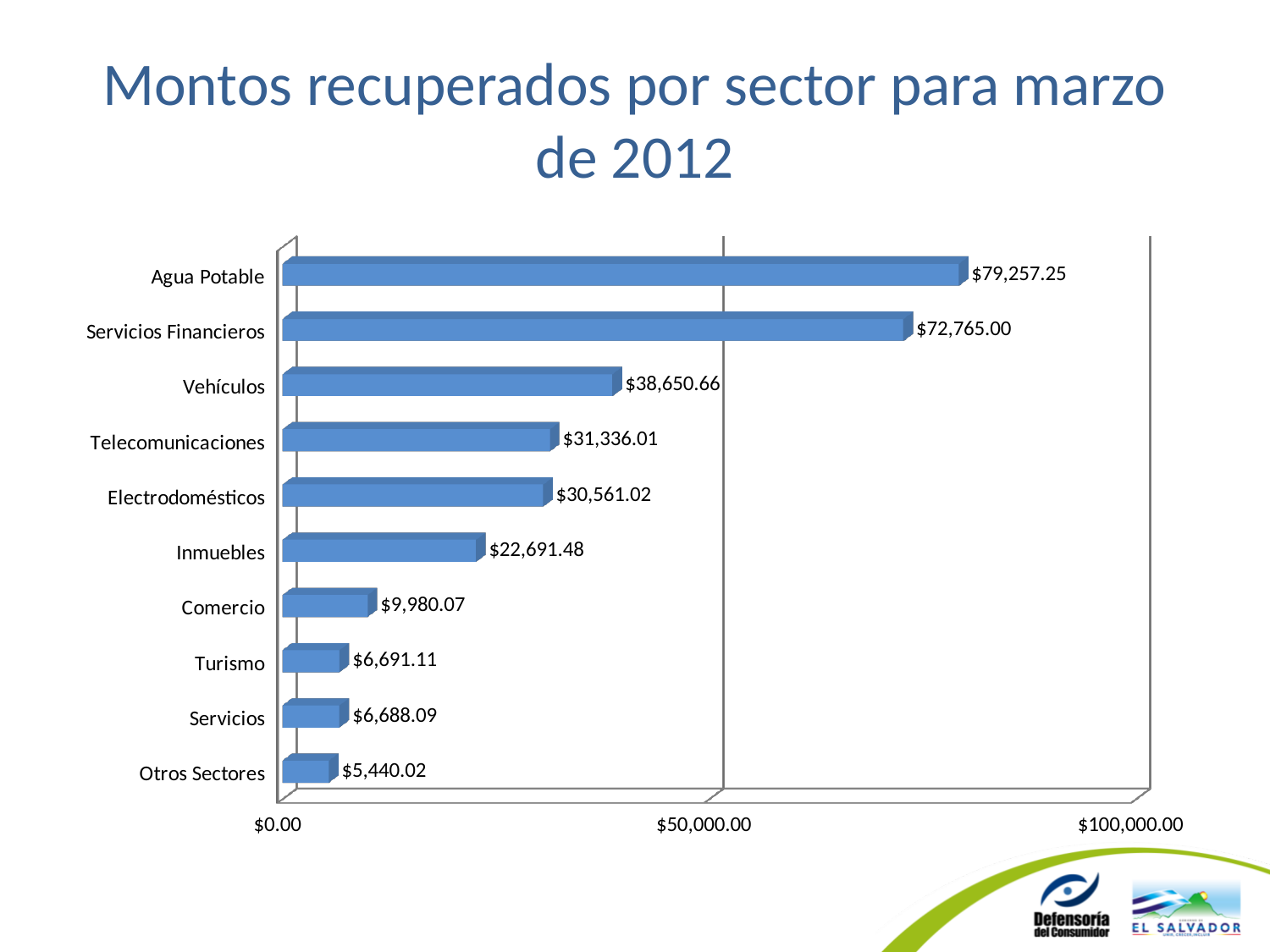
What is the value for Telecomunicaciones? $31,336.01 What kind of chart is shown on the slide? bar chart Which is larger, the value for Vehículos or the value for Inmuebles? Vehículos Is the value for Servicios Financieros greater or less than $50,000.00? greater What is the value for Comercio? $9,980.07 What is the difference between the values for Agua Potable and Servicios Financieros? $6,492.25 What is the difference between the values for Vehículos and Telecomunicaciones? $7,314.65 Which sector has the highest recovered amount? Agua Potable How many sectors are shown in the chart? 10 What is the title of the chart? Montos recuperados por sector para marzo de 2012 What is the value for Agua Potable? $79,257.25 Which sector has the lowest recovered amount? Otros Sectores